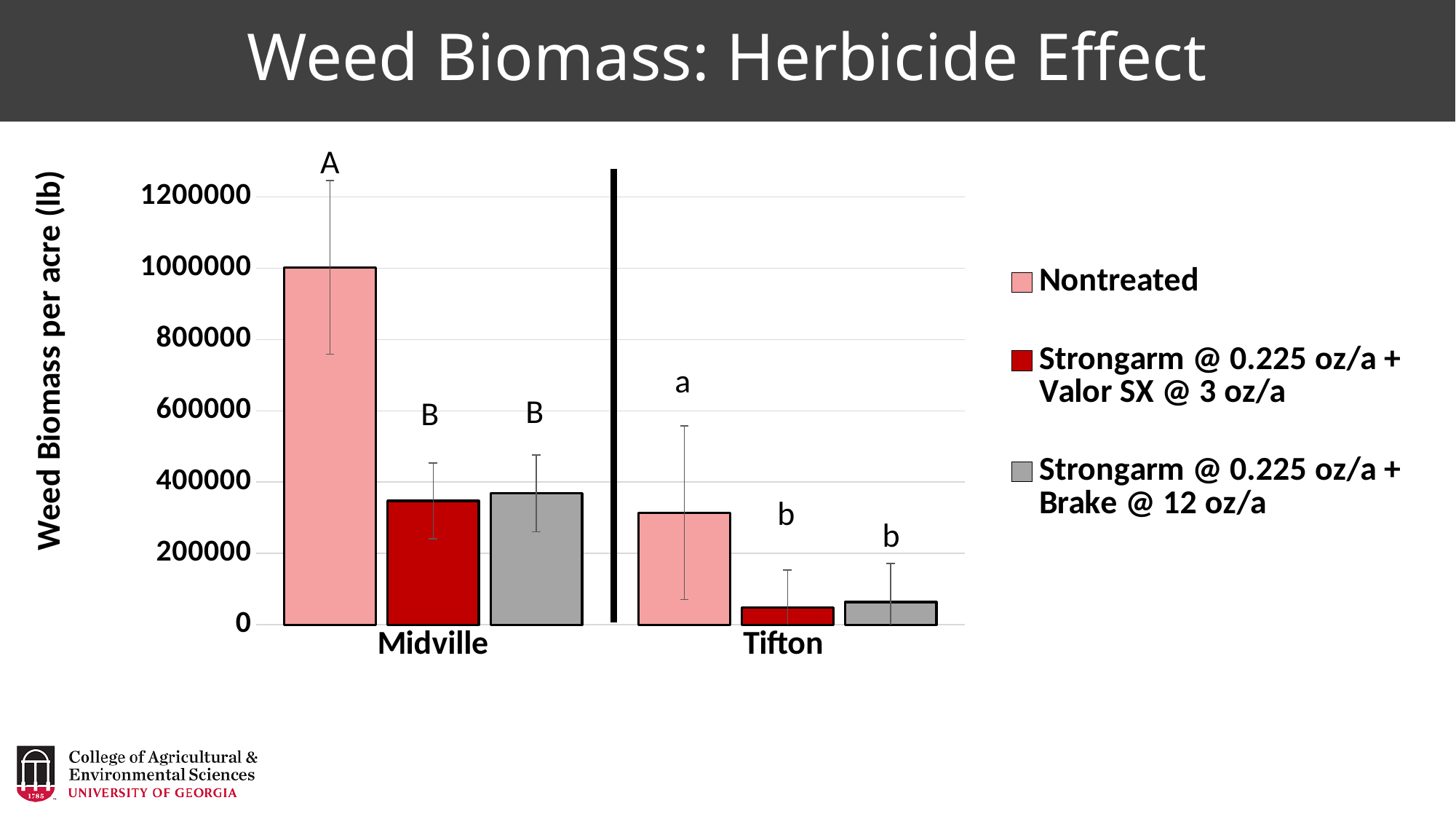
What kind of chart is shown on the slide? bar chart Is the Nontreated value at Tifton greater or less than 400000? less Which is larger, the Nontreated value at Midville or the Nontreated value at Tifton? Midville What is the title of the slide? Weed Biomass: Herbicide Effect Which bar is the highest on the chart? Nontreated at Midville Is the Strongarm @ 0.225 oz/a + Brake @ 12 oz/a value at Tifton greater or less than 200000? less Is the Nontreated value at Midville greater or less than 800000? greater How many series does the legend list? 3 Which location has the lower Nontreated weed biomass? Tifton What is the y-axis title of the chart? Weed Biomass per acre (lb) How many locations are shown on the x axis? 2